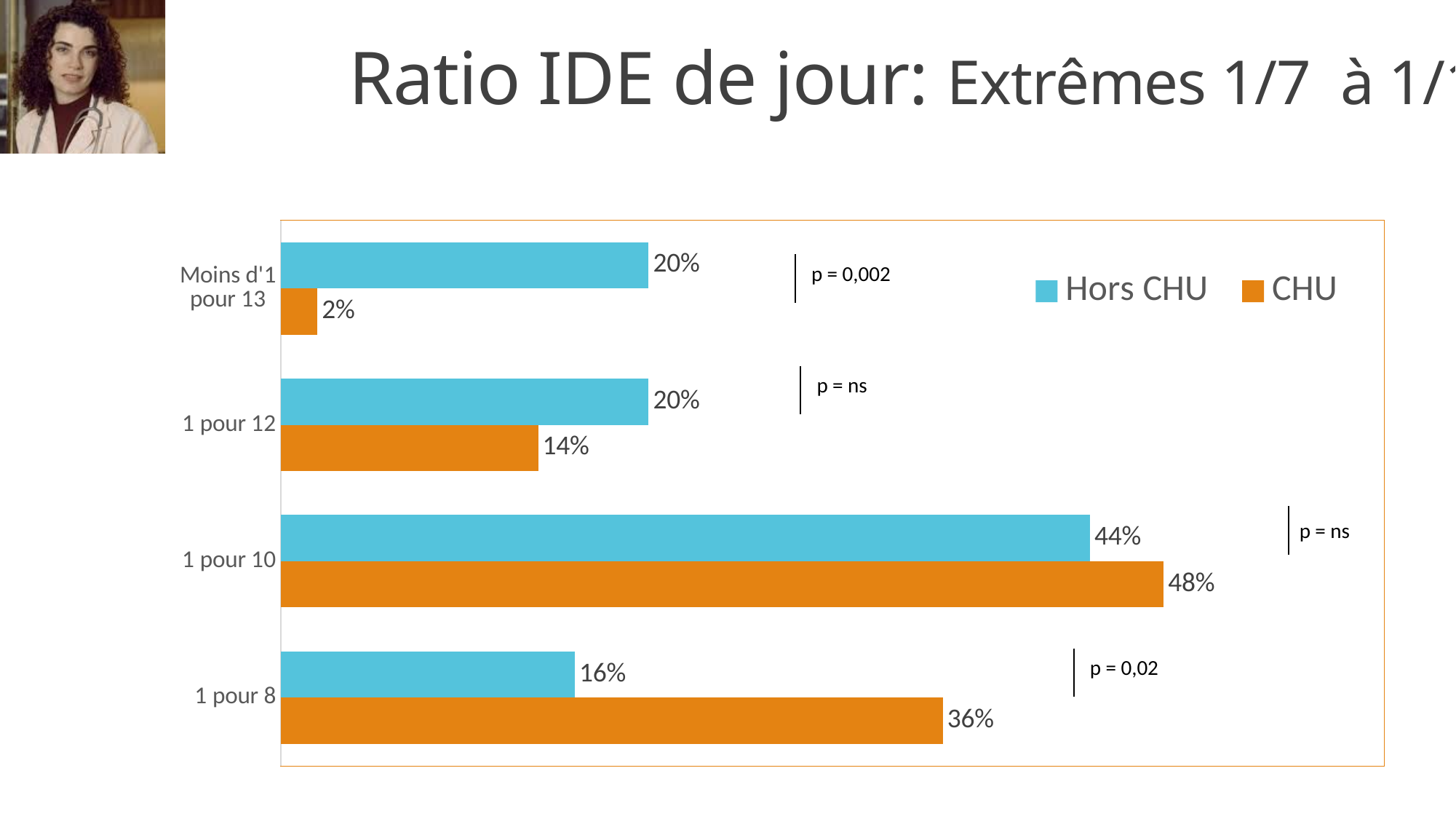
How many series does the legend list? 2 Which category has the lowest CHU value? Moins d'1 pour 13 Which category has the lowest Hors CHU value? 1 pour 8 What kind of chart is shown on the slide? Bar chart For '1 pour 10', which series has the larger value, Hors CHU or CHU? CHU What is the difference between the Hors CHU and CHU values for '1 pour 12'? 6% What is the CHU value for the category 'Moins d'1 pour 13'? 2% What is the CHU value for the category '1 pour 8'? 36% What is the Hors CHU value for the category '1 pour 10'? 44% What is the difference between the CHU and Hors CHU values for '1 pour 8'? 20% Which category has the highest CHU value? 1 pour 10 How many categories are shown on the chart? 4